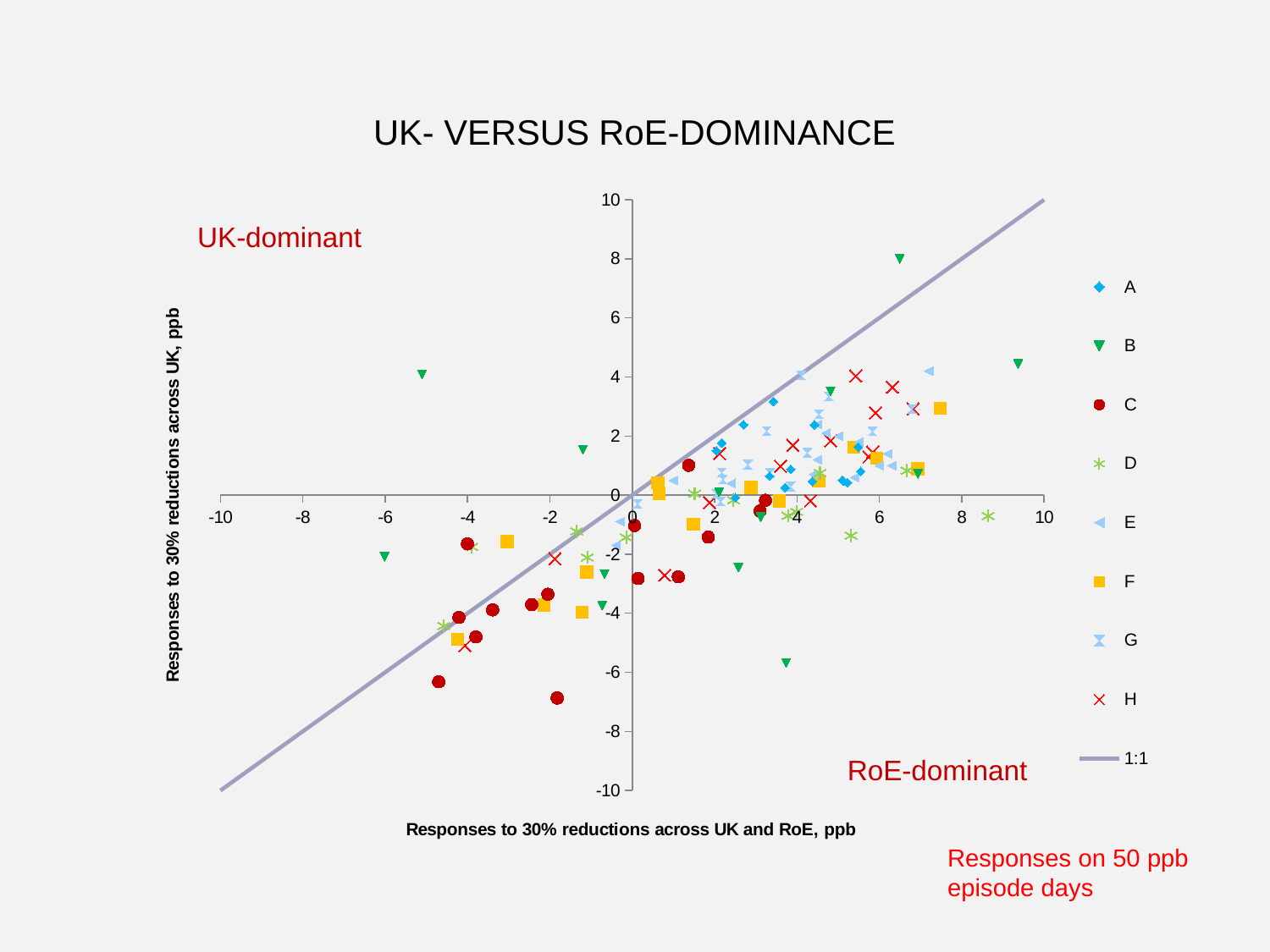
Which series contains the point with the highest value on the vertical axis? B Is the largest horizontal-axis value reached by series B greater or less than 8? greater What is the title of the horizontal axis? Responses to 30% reductions across UK and RoE, ppb What kind of chart is shown on the slide? scatter chart Is the lowest vertical-axis value reached by series C greater or less than -6? less How many entries does the chart legend list? 9 Which series reaches a higher maximum on the vertical axis, B or F? B Is the largest horizontal-axis value reached by series D greater or less than 8? greater What is the title of the chart? UK- VERSUS RoE-DOMINANCE Which series contains the point with the lowest value on the vertical axis? C Which series reaches a lower minimum on the vertical axis, C or A? C